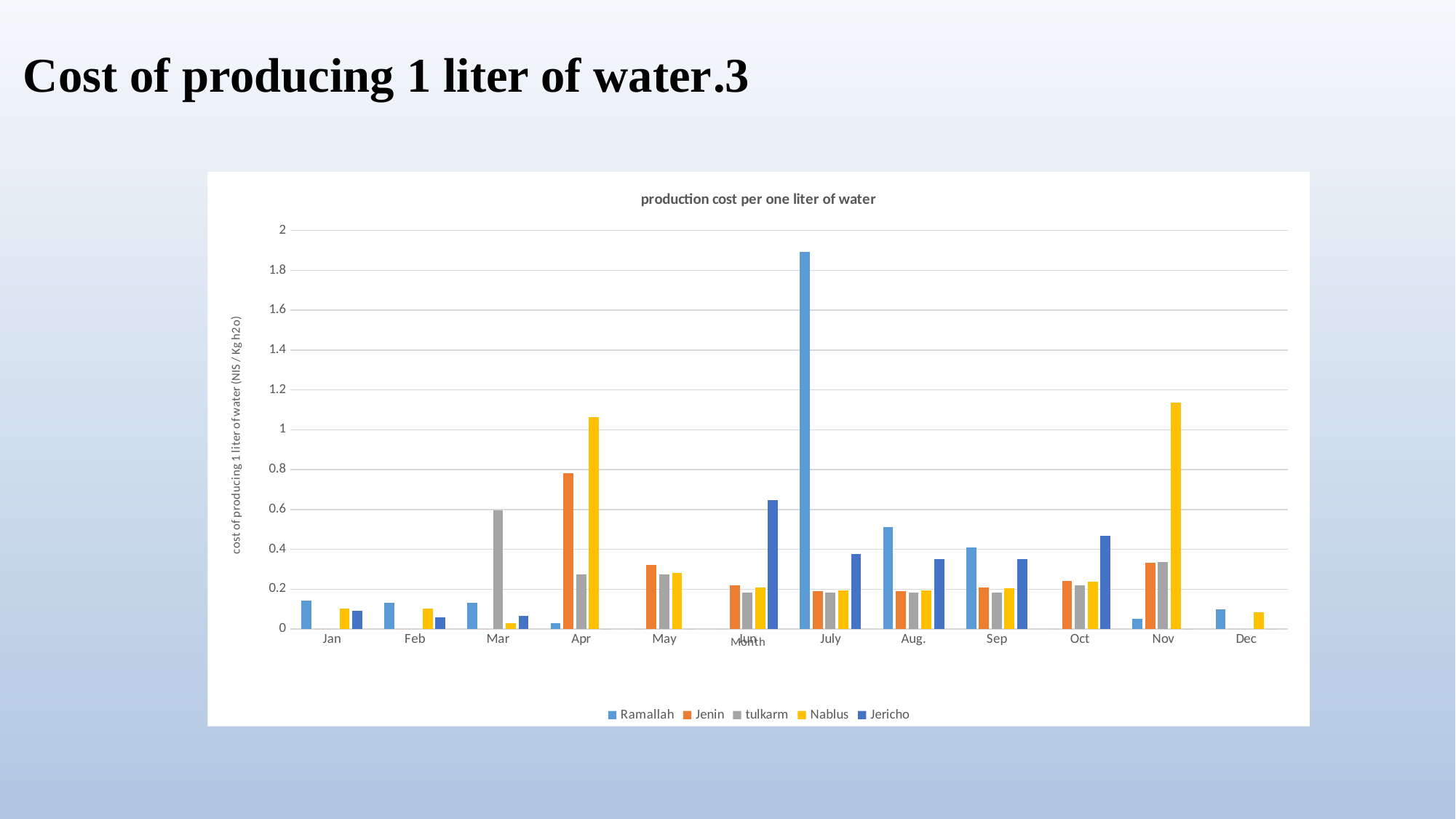
Is the value for tulkarm in Mar greater or less than 0.4? greater Which is larger: Jenin in Apr or tulkarm in Mar? Jenin in Apr Is the value for Nablus in Apr greater or less than 1? greater Is the value for Nablus in Nov greater or less than 1? greater How many months are shown along the x axis? 12 Which city has the highest bar in Oct? Jericho In which month is the Ramallah bar highest? July How many series does the legend list? 5 What is the title of the chart? production cost per one liter of water What kind of chart is shown on the slide? bar chart